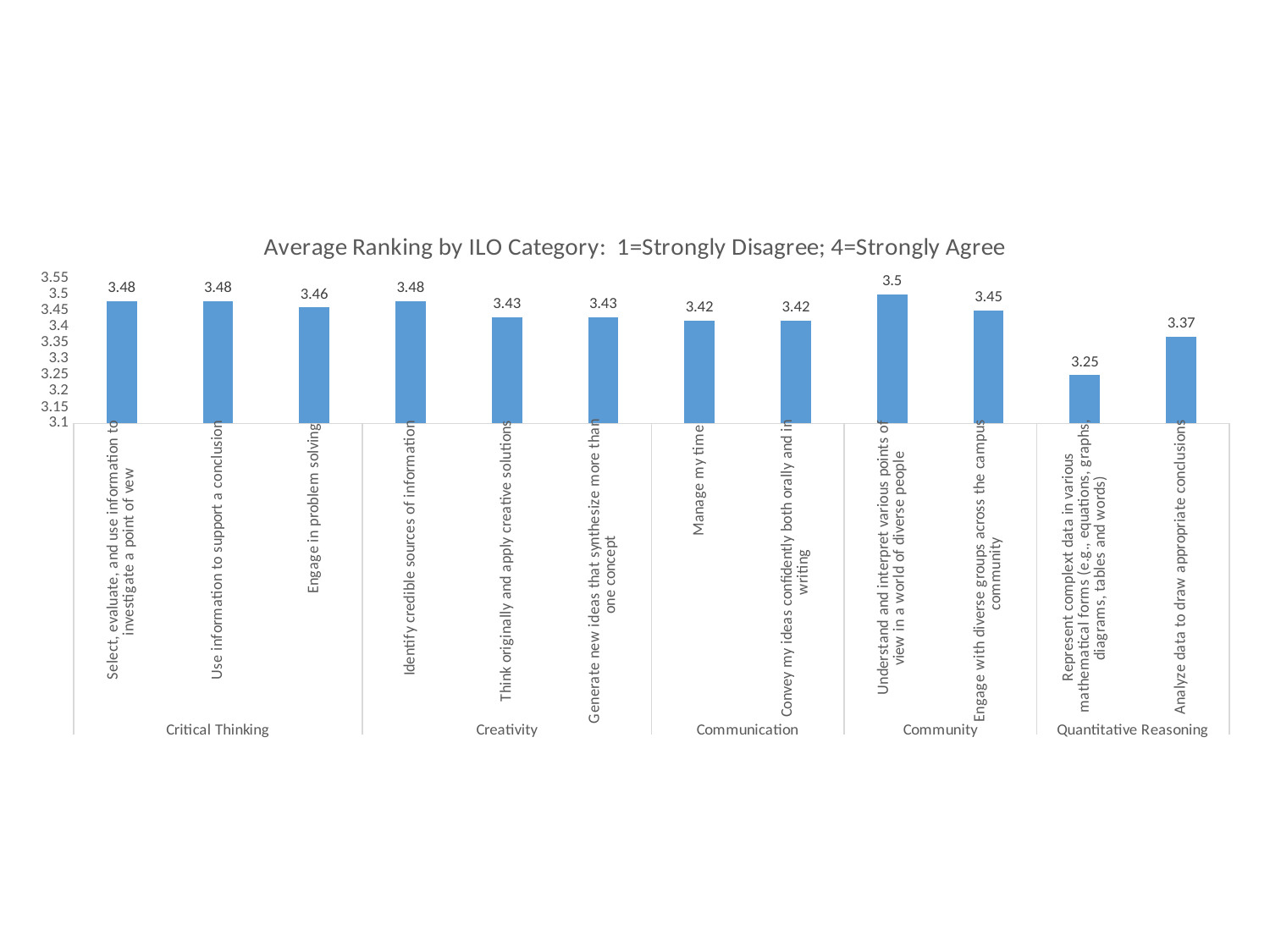
How many bars are plotted in the chart? 12 Is the value for "Represent complext data in various mathematical forms" greater or less than 3.3? less Which has a higher average ranking: "Engage with diverse groups across the campus community" or "Analyze data to draw appropriate conclusions"? Engage with diverse groups across the campus community What is the average ranking for "Manage my time"? 3.42 What is the title of the chart? Average Ranking by ILO Category: 1=Strongly Disagree; 4=Strongly Agree What is the difference between the highest average ranking (3.5) and the lowest (3.25)? 0.25 What is the average ranking for "Analyze data to draw appropriate conclusions"? 3.37 Which item has the highest average ranking? Understand and interpret various points of view in a world of diverse people Which item has the lowest average ranking? Represent complext data in various mathematical forms (e.g., equations, graphs diagrams, tables and words) How many ILO category groups are shown along the x axis? 5 What type of chart is shown on the slide? Bar chart What is the average ranking for "Engage in problem solving"? 3.46